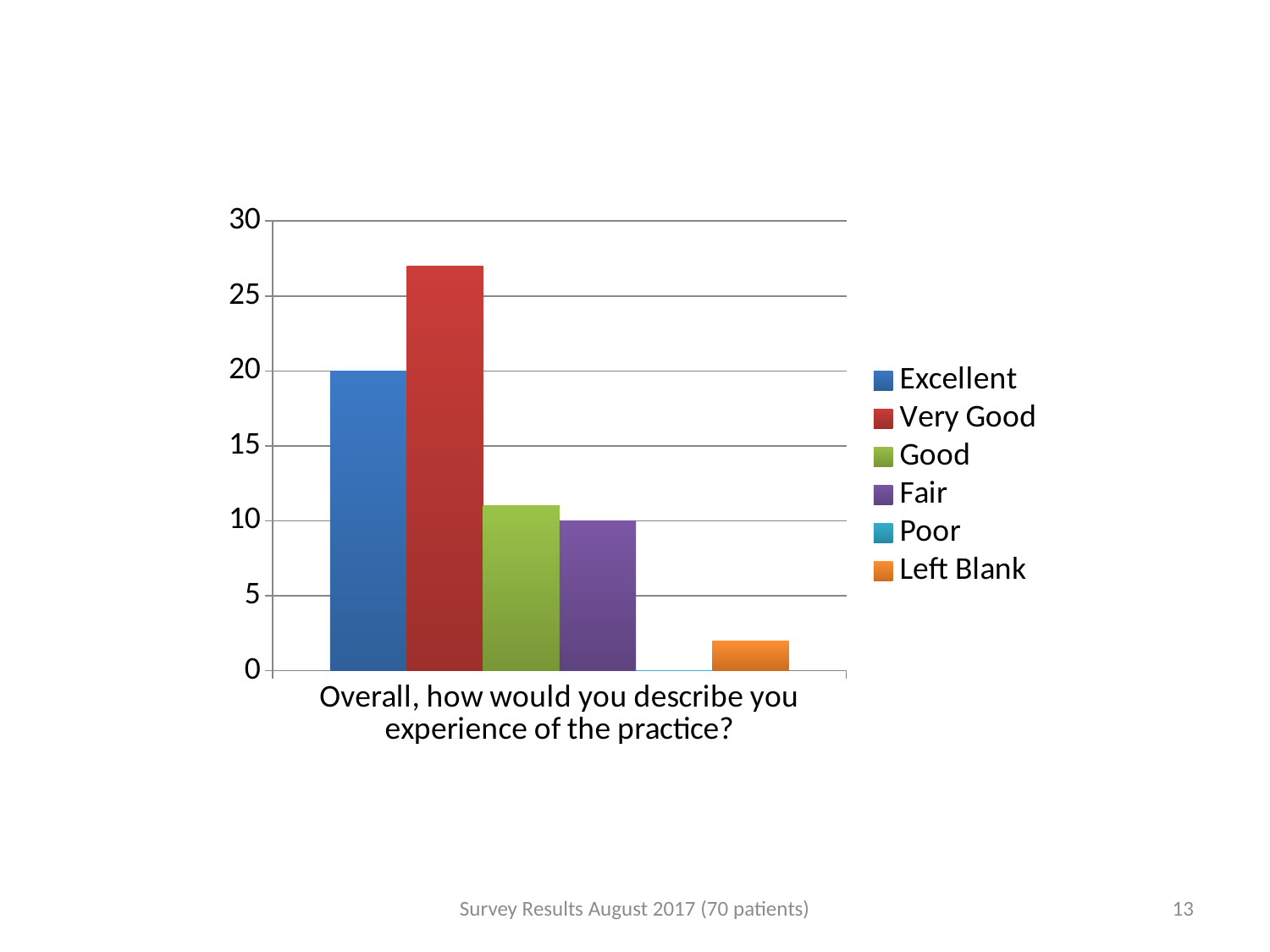
What is the value for Fair? 10 What is the value for Poor? 0 Which response has the lowest value? Poor Which is larger, the value for Excellent or the value for Good? Excellent What is the difference between the values for Excellent and Fair? 10 What is the value for Excellent? 20 What kind of chart is shown on the slide? bar chart Is the value for Very Good greater or less than 25? greater Is the value for Left Blank greater or less than 5? less Which response has the highest value? Very Good Is the value for Good greater or less than 15? less How many series does the legend list? 6